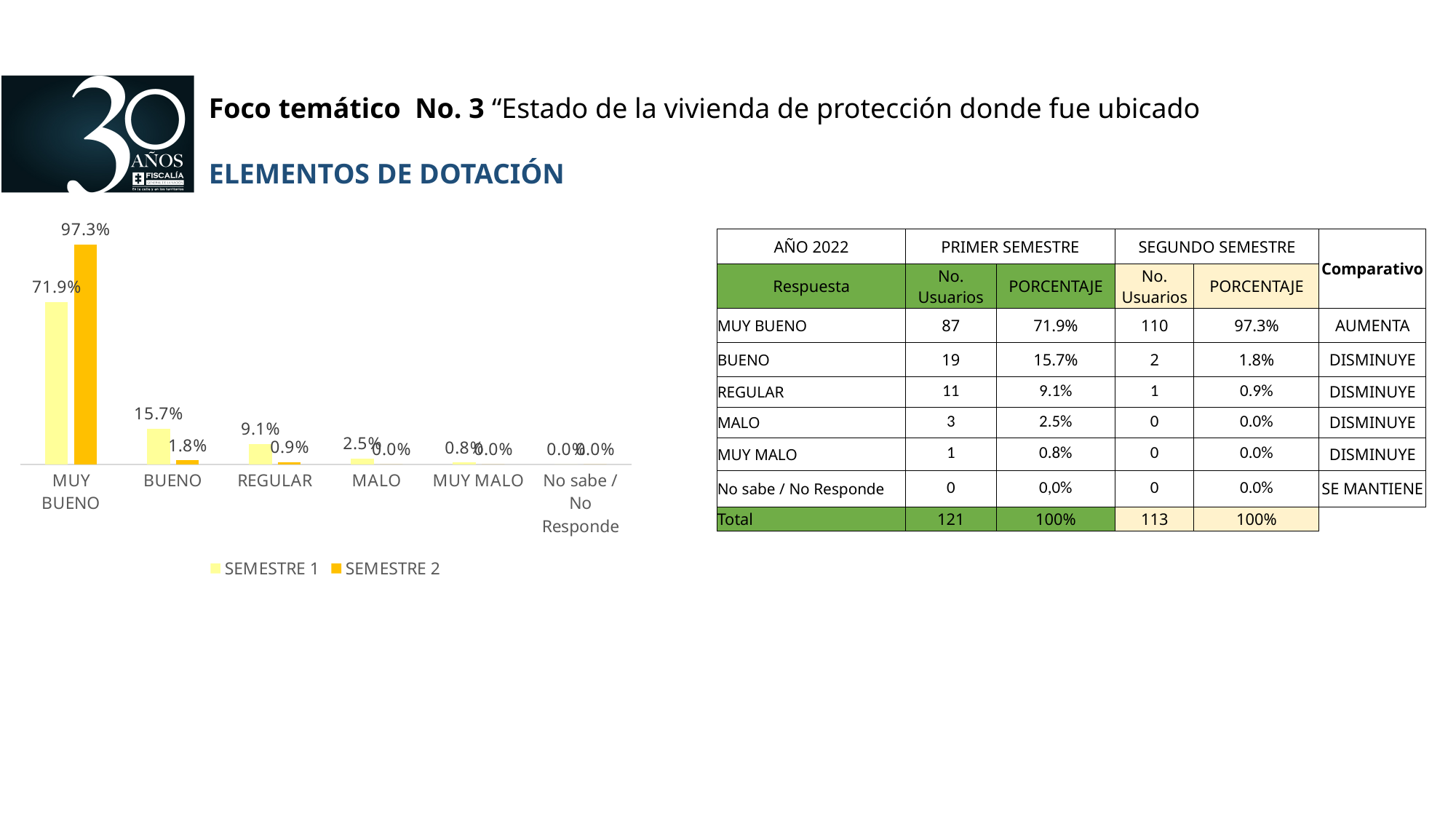
How many categories are shown on the x axis of the chart? 6 How many series does the chart legend list? 2 Which is larger for BUENO, the SEMESTRE 1 value or the SEMESTRE 2 value? SEMESTRE 1 Which category has the highest SEMESTRE 1 value? MUY BUENO What is the SEMESTRE 2 value for BUENO? 1.8% What are the two series named in the chart legend? SEMESTRE 1 and SEMESTRE 2 What is the SEMESTRE 1 value for REGULAR? 9.1% Do the SEMESTRE 1 values rise or fall from MUY BUENO to MUY MALO? Fall What kind of chart is shown on the slide? Bar chart What is the SEMESTRE 2 value for MUY BUENO? 97.3% What is the difference between the SEMESTRE 2 and SEMESTRE 1 values for MUY BUENO? 25.4% What is the SEMESTRE 1 value for BUENO? 15.7%